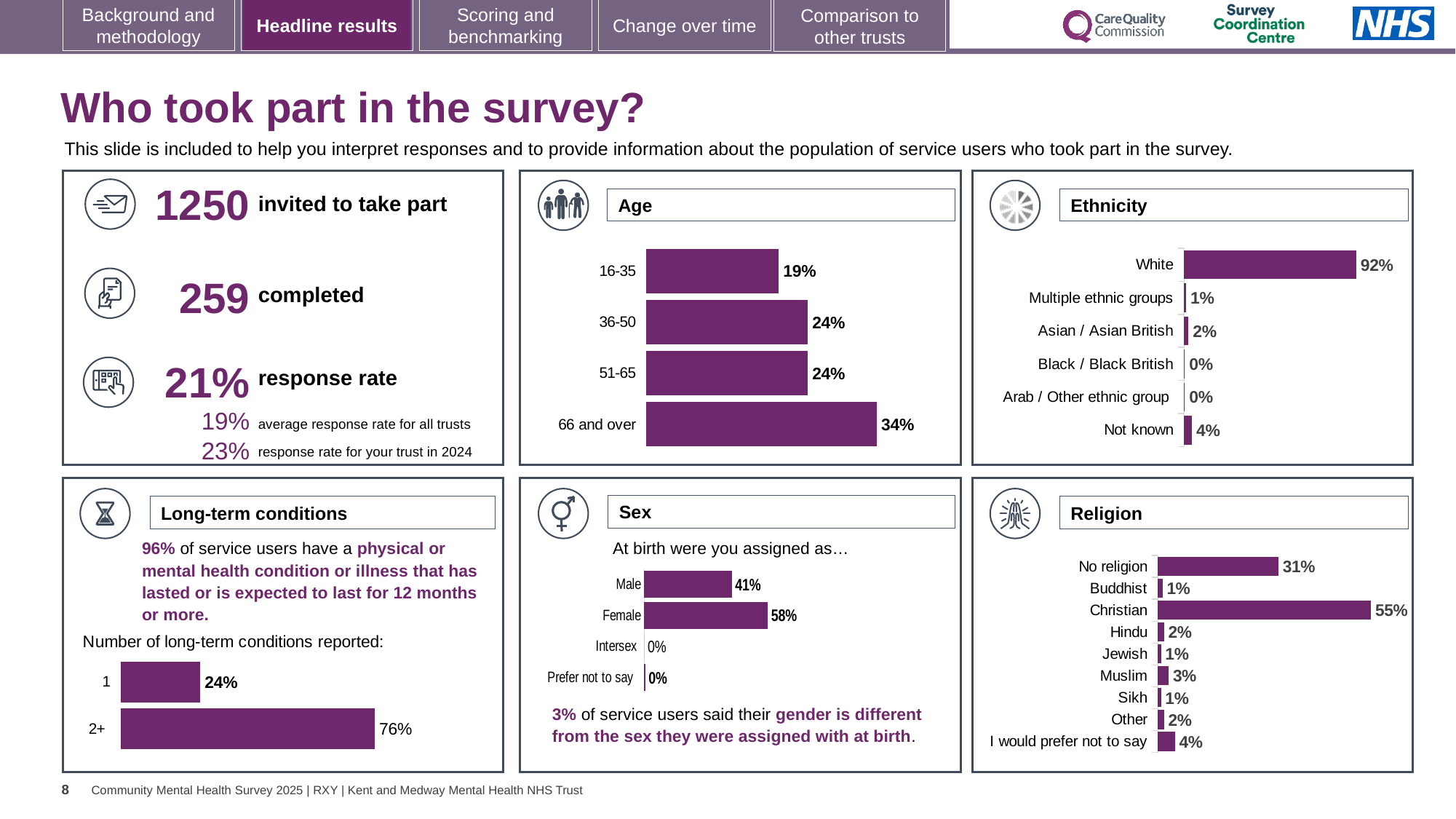
In the Sex chart, what percentage of respondents were assigned Female at birth? 58% In the Religion chart, what percentage of respondents reported No religion? 31% In the Religion chart, which religion category has the highest percentage? Christian In the Age chart, how many age categories are shown? 4 In the Age chart, which age group has the lowest percentage? 16-35 What type of chart is used in the Religion panel? Bar chart In the Sex chart, which is larger, the percentage for Male or for Female? Female In the Age chart, what percentage of respondents were aged 66 and over? 34% In the Ethnicity chart, what is the difference between the percentages for White and Not known? 88% In the Ethnicity chart, how many ethnicity categories are listed? 6 In the Long-term conditions chart, what percentage of respondents reported 2+ long-term conditions? 76% In the Ethnicity chart, what percentage of respondents were White? 92%